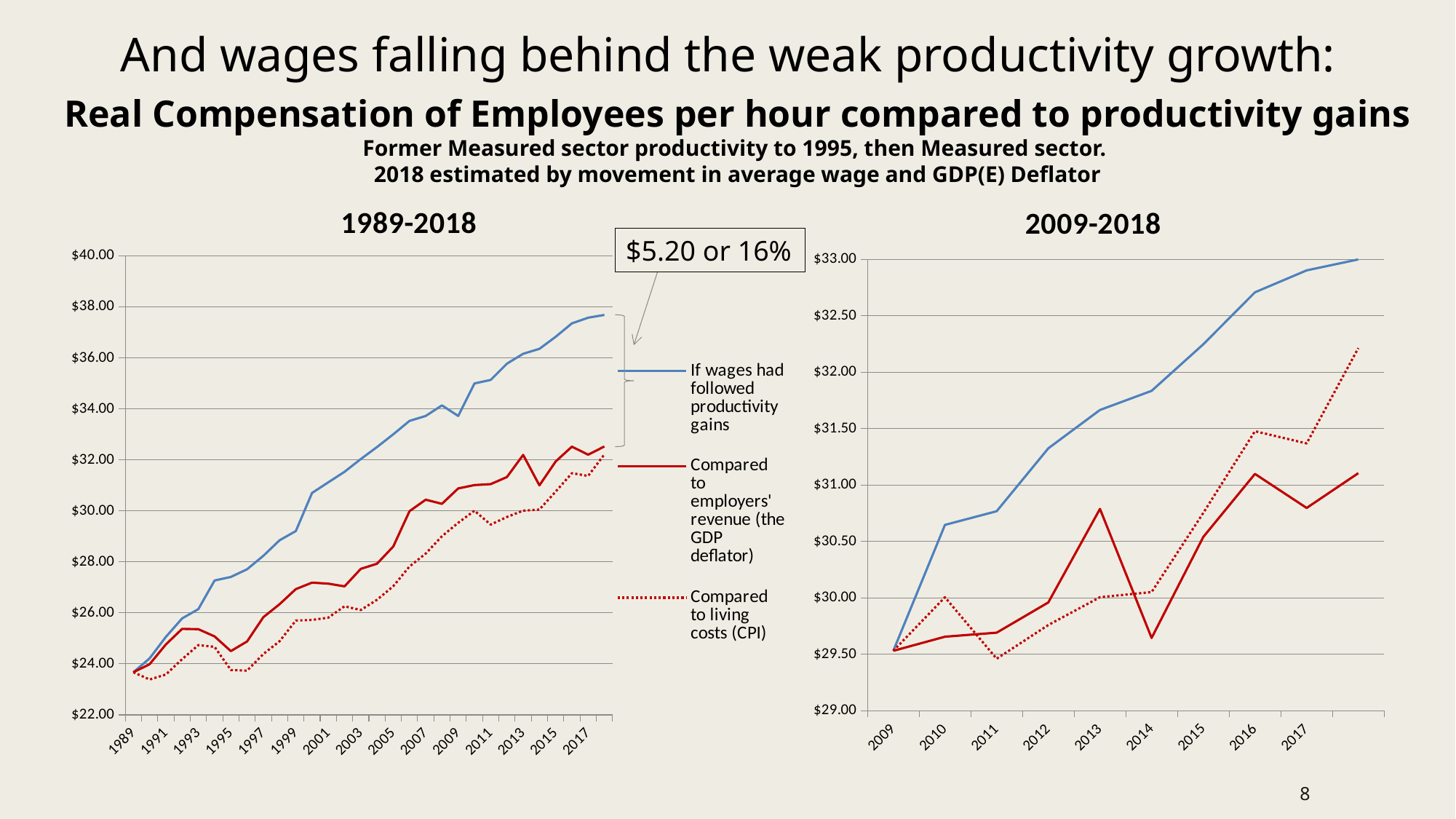
In the 2009-2018 chart, which series has the highest value at the end of the period? If wages had followed productivity gains In the 1989-2018 chart, does the 'If wages had followed productivity gains' line rise or fall from 1989 to 2018? rise In the 2009-2018 chart, does the 'If wages had followed productivity gains' line rise or fall across the period? rise What gap does the annotation on the 1989-2018 chart state between wages following productivity gains and actual compensation? $5.20 or 16% What type of chart is the 1989-2018 chart? line chart In the 1989-2018 chart, is the value for 'Compared to living costs (CPI)' in 1995 greater or less than $26.00? less How many series does the legend list? 3 In the 2009-2018 chart, is the value for 'Compared to employers' revenue (the GDP deflator)' in 2014 greater or less than $30.00? less How many charts are shown on the slide? 2 In the 2009-2018 chart, which is larger in 2013: 'Compared to employers' revenue (the GDP deflator)' or 'Compared to living costs (CPI)'? Compared to employers' revenue (the GDP deflator) In the 1989-2018 chart, is the value for 'If wages had followed productivity gains' in 2017 greater or less than $36.00? greater